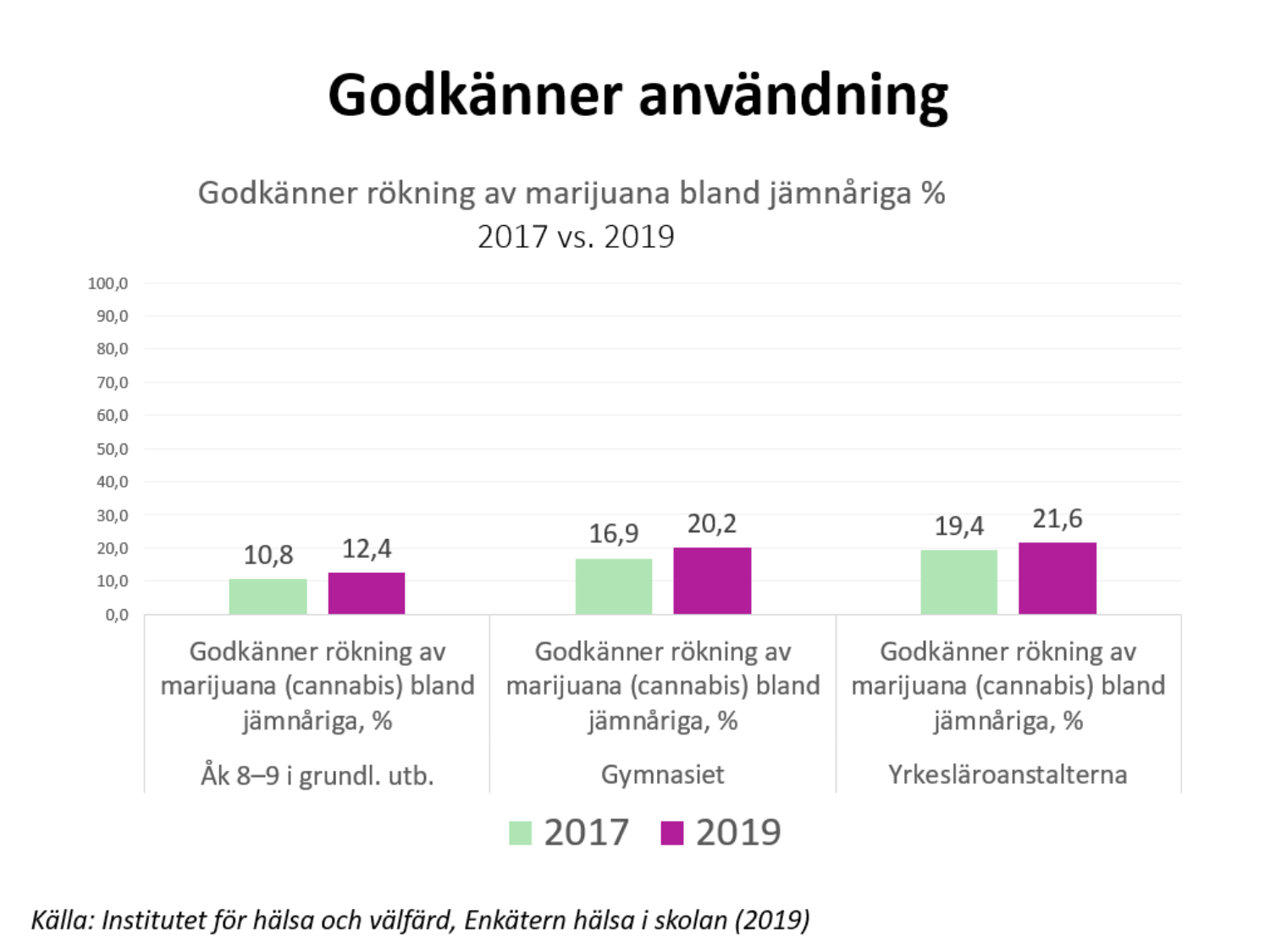
Which category has the lowest 2017 value? Åk 8–9 i grundl. utb. What is the difference between the 2019 and 2017 values for Gymnasiet? 3,3 Which is larger for Yrkesläroanstalterna, the 2017 value or the 2019 value? 2019 Which category has the highest 2019 value? Yrkesläroanstalterna What is the 2017 value for Åk 8–9 i grundl. utb.? 10,8 How many categories are shown on the x axis? 3 What is the 2019 value for Gymnasiet? 20,2 Which colour represents the 2019 series? purple What is the 2017 value for Yrkesläroanstalterna? 19,4 Is the 2019 value for Åk 8–9 i grundl. utb. greater or less than 20,0? less What kind of chart is shown? bar chart How many series does the legend list? 2